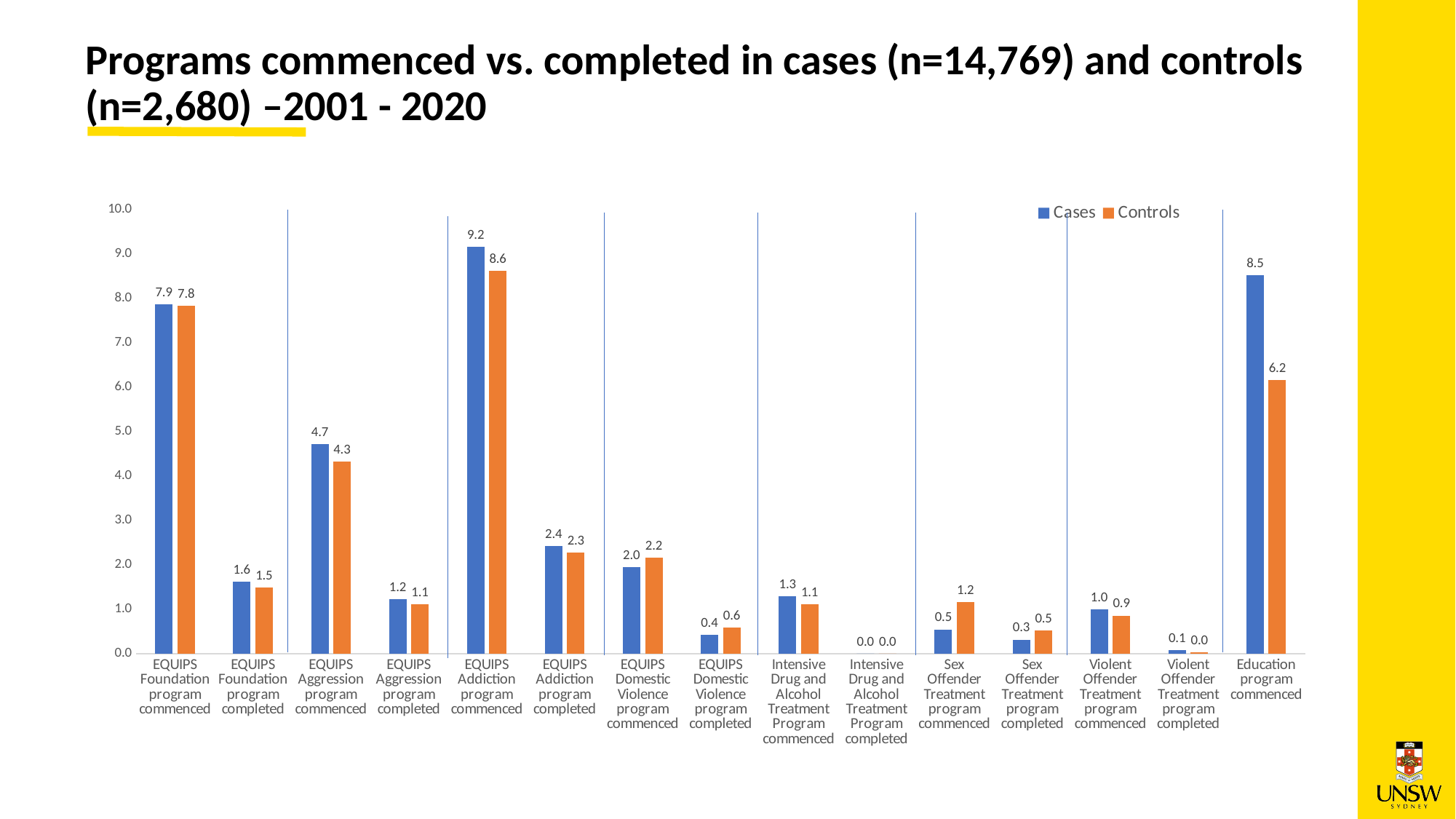
What is the difference between Cases and Controls for Education program commenced? 2.3 Which is larger for Sex Offender Treatment program commenced, Cases or Controls? Controls Which category has the highest value for Cases? EQUIPS Addiction program commenced How many categories are shown on the x axis? 15 Which category has the highest value for Controls? EQUIPS Addiction program commenced What is the value for Controls for Sex Offender Treatment program commenced? 1.2 What kind of chart is shown on the slide? Bar chart How many series does the legend list? 2 What is the value for Cases for EQUIPS Addiction program commenced? 9.2 Which is larger for EQUIPS Addiction program commenced, Cases or Controls? Cases What is the difference between Cases and Controls for EQUIPS Aggression program commenced? 0.4 What is the value for Controls for Education program commenced? 6.2